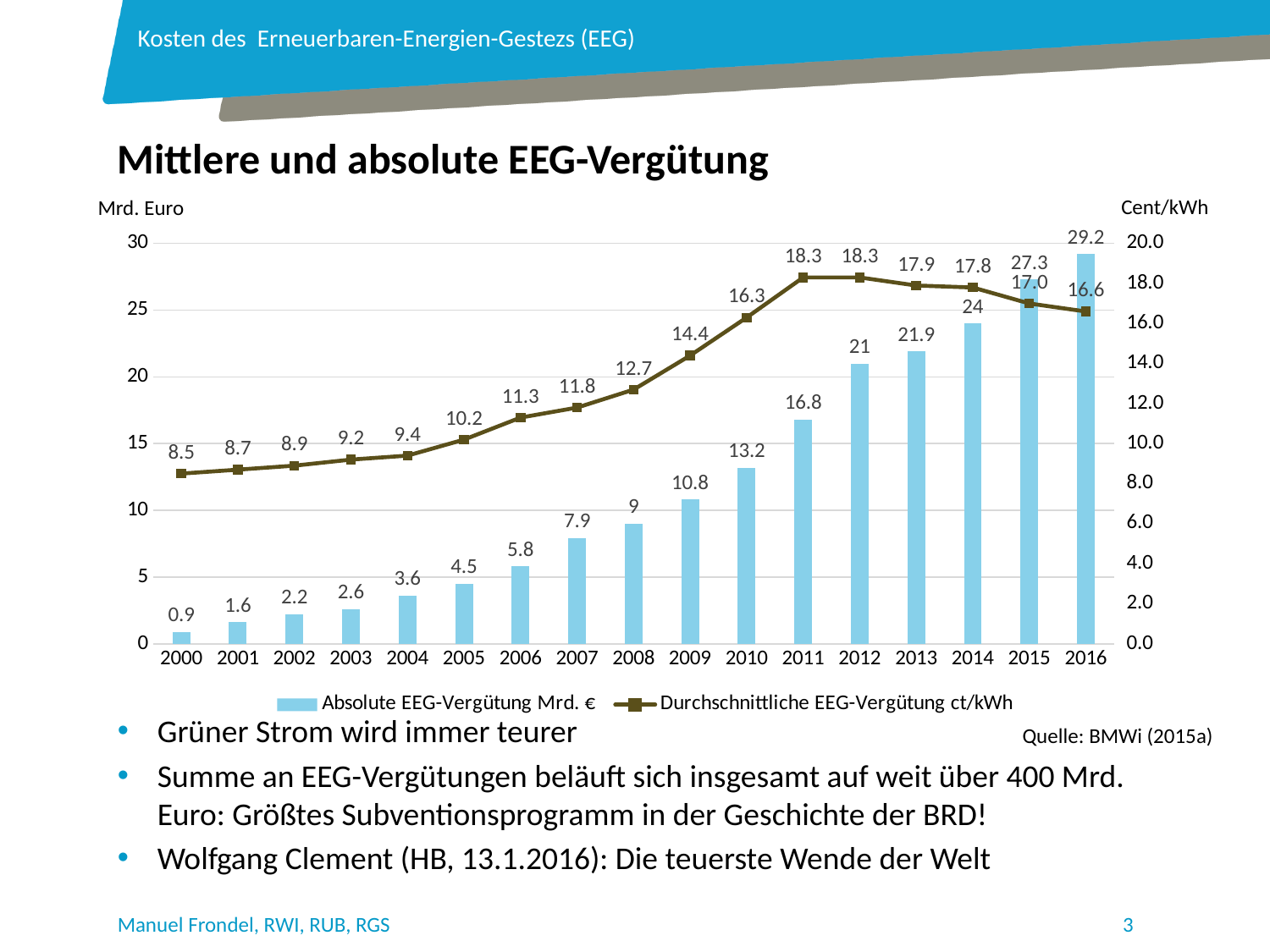
How many series does the legend list? 2 What is the absolute EEG-Vergütung (Mrd. €) for 2016? 29.2 Which year has the highest absolute EEG-Vergütung (Mrd. €)? 2016 How many years are shown on the x axis of the chart? 17 Does the absolute EEG-Vergütung (Mrd. €) rise or fall from 2000 to 2016? rise What is the absolute EEG-Vergütung (Mrd. €) for 2005? 4.5 Is the absolute EEG-Vergütung (Mrd. €) larger in 2013 or in 2012? 2013 Which year has the lowest absolute EEG-Vergütung (Mrd. €)? 2000 What is the difference in absolute EEG-Vergütung (Mrd. €) between 2016 and 2015? 1.9 What is the durchschnittliche EEG-Vergütung (ct/kWh) for 2009? 14.4 What is the title of the chart? Mittlere und absolute EEG-Vergütung What is the difference in durchschnittliche EEG-Vergütung (ct/kWh) between 2011 and 2000? 9.8